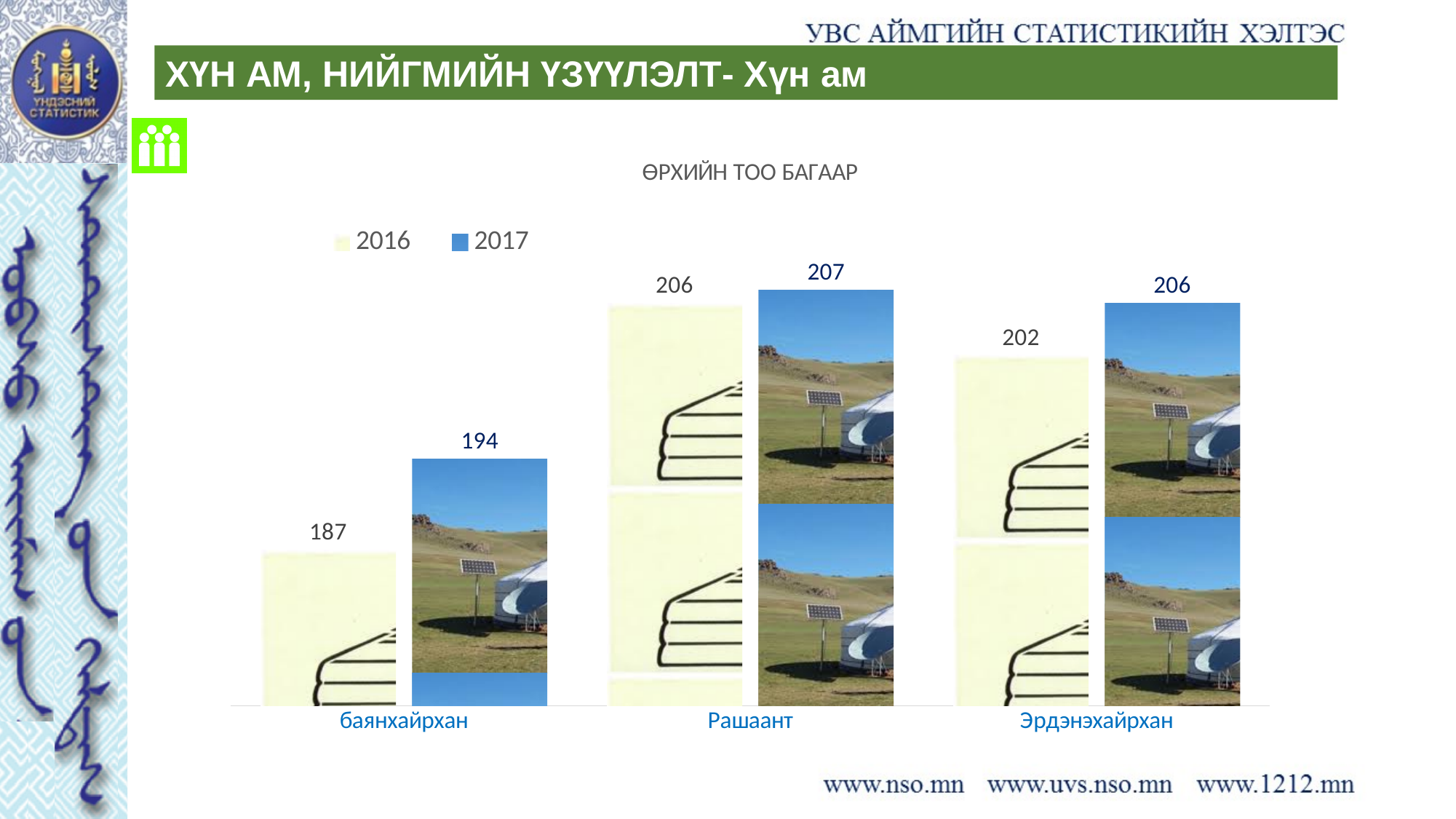
Which category has the highest value in 2017? Рашаант What is the value for Эрдэнэхайрхан in 2016? 202 Which is larger for Рашаант: the 2016 value or the 2017 value? 2017 Which category has the lowest value in 2016? баянхайрхан What is the value for баянхайрхан in 2016? 187 What is the value for Эрдэнэхайрхан in 2017? 206 What is the value for Рашаант in 2017? 207 How many categories are shown on the x axis? 3 What is the difference between the 2017 and 2016 values for Эрдэнэхайрхан? 4 What is the difference between the 2017 and 2016 values for баянхайрхан? 7 What is the title of the chart? ӨРХИЙН ТОО БАГААР How many series does the legend list? 2